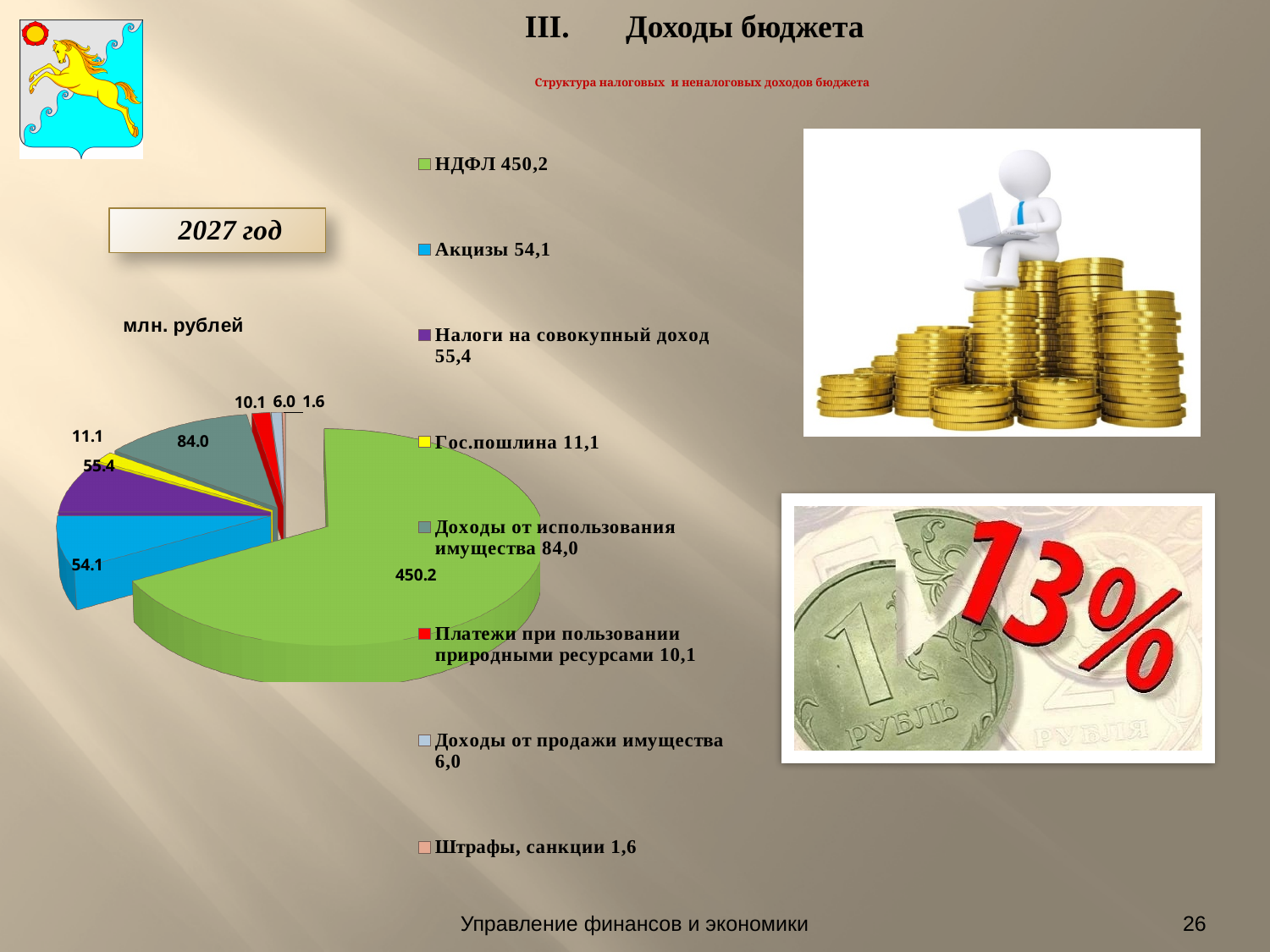
What is the value for Акцизы in the pie chart? 54.1 What is the value for Штрафы, санкции? 1.6 What is the value for НДФЛ in the pie chart? 450.2 Which category has the largest slice of the pie chart? НДФЛ What unit is stated for the values in the pie chart? млн. рублей Which year does the pie chart refer to? 2027 год What is the difference between Доходы от использования имущества and Акцизы? 29.9 Which is larger: Доходы от использования имущества or Гос.пошлина? Доходы от использования имущества What is the value for Доходы от использования имущества? 84.0 Which category has the smallest slice of the pie chart? Штрафы, санкции How many categories does the pie chart show? 8 What type of chart is shown on the slide? pie chart